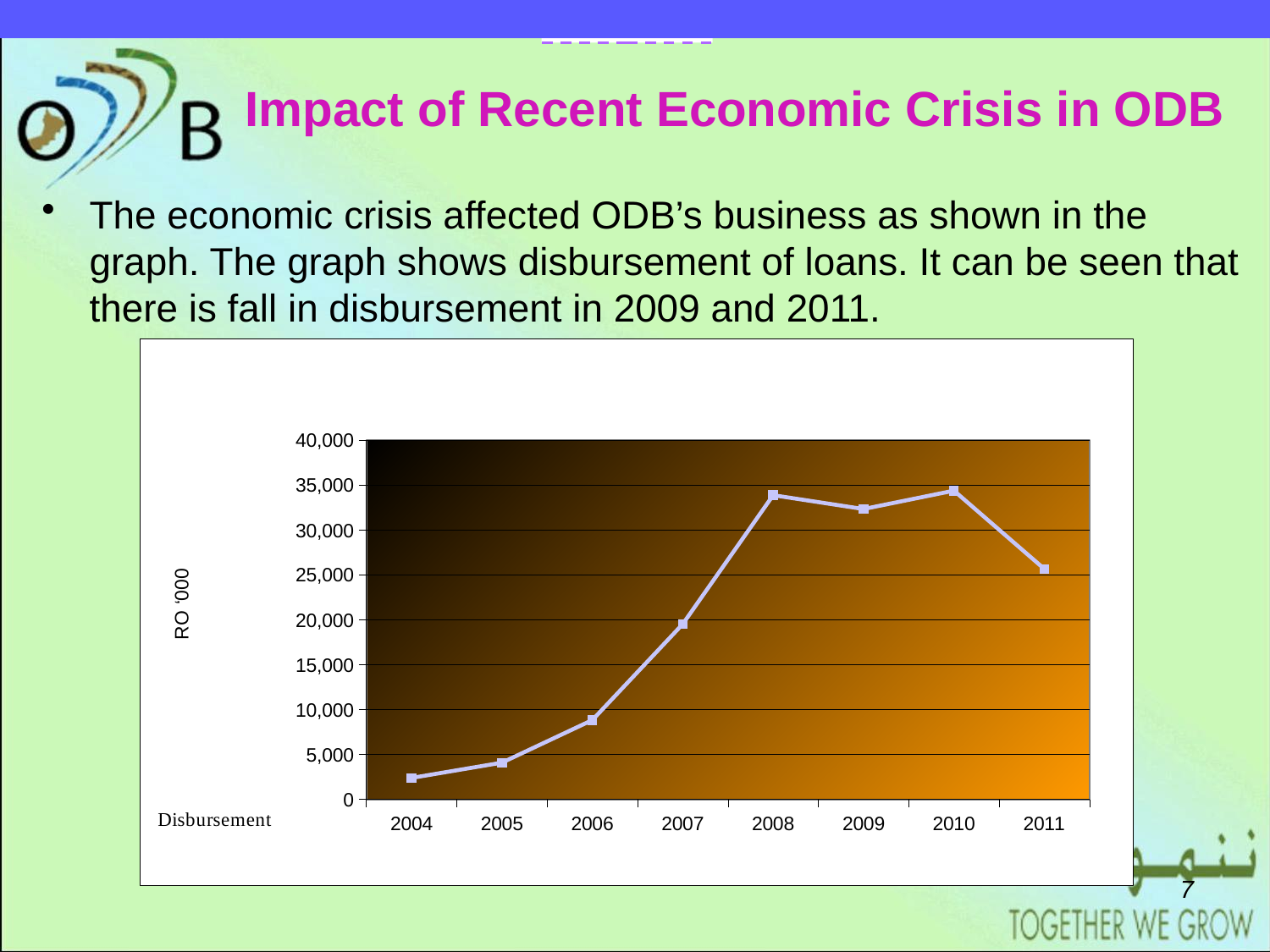
Is the disbursement value for 2004 greater or less than 5,000? less Is the disbursement value for 2011 greater or less than 30,000? less Which year has the larger disbursement value, 2010 or 2011? 2010 Is the disbursement value for 2006 greater or less than 10,000? less Which year has the lowest disbursement value in the chart? 2004 Which year has the larger disbursement value, 2006 or 2007? 2007 Do the disbursement values rise or fall from 2004 to 2008? rise How many years are plotted on the x axis of the chart? 8 What kind of chart is shown on the slide? line chart What is the label on the vertical axis of the chart? RO '000